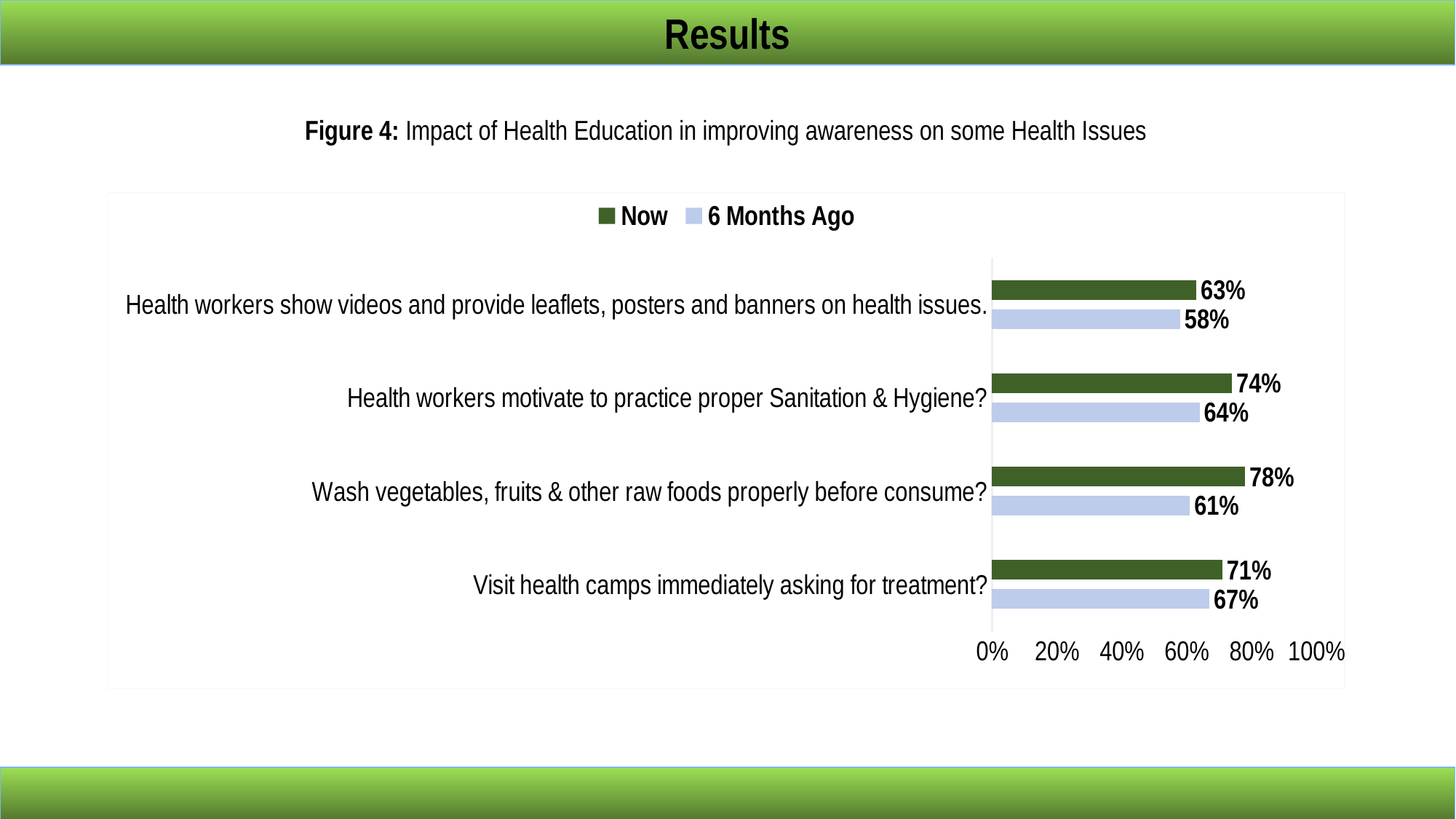
What kind of chart is shown on the slide? Bar chart What is the '6 Months Ago' value for 'Health workers show videos and provide leaflets, posters and banners on health issues.'? 58% Which is larger: the 'Now' value for 'Visit health camps immediately asking for treatment?' or the 'Now' value for 'Health workers motivate to practice proper Sanitation & Hygiene?' Health workers motivate to practice proper Sanitation & Hygiene? What is the difference between the 'Now' and '6 Months Ago' values for 'Wash vegetables, fruits & other raw foods properly before consume?' 17% Which category has the highest 'Now' value? Wash vegetables, fruits & other raw foods properly before consume? How many series does the legend list? 2 What is the 'Now' value for 'Wash vegetables, fruits & other raw foods properly before consume?' 78% How many categories are shown on the chart? 4 Which category has the lowest '6 Months Ago' value? Health workers show videos and provide leaflets, posters and banners on health issues. What is the '6 Months Ago' value for 'Visit health camps immediately asking for treatment?' 67% Which series is shown in dark green? Now What is the difference between the 'Now' and '6 Months Ago' values for 'Health workers motivate to practice proper Sanitation & Hygiene?' 10%